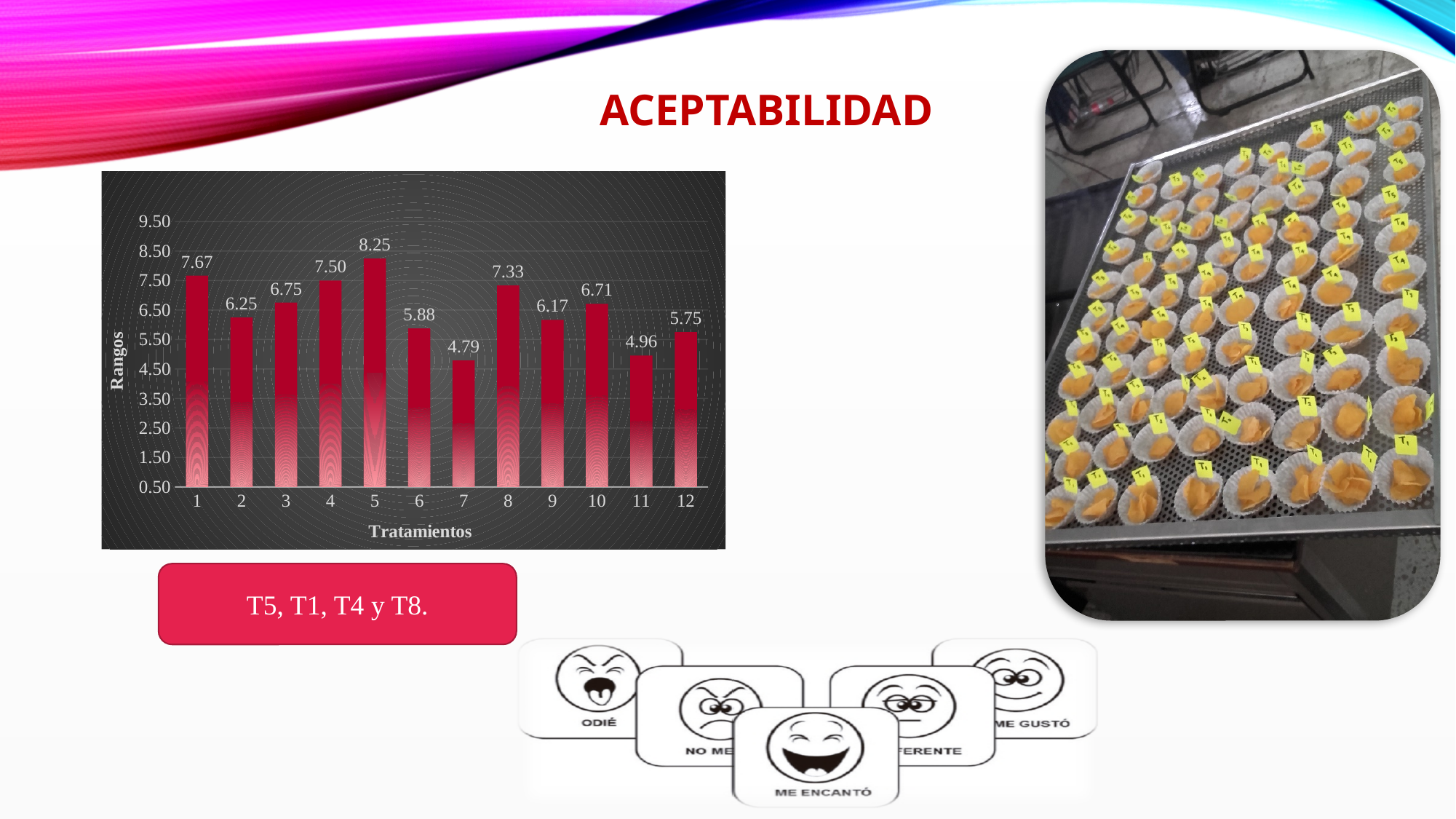
Which treatment has the lowest value? 7 What is the value for treatment 5? 8.25 Which treatment has the highest value? 5 Which has a larger value, treatment 4 or treatment 8? Treatment 4 What is the value for treatment 7? 4.79 Is the value for treatment 11 greater or less than 5.50? less What is the difference between the values for treatment 1 and treatment 2? 1.42 What is the value for treatment 10? 6.71 What kind of chart is shown on the slide? Bar chart How many treatments are shown on the x axis? 12 What is the label of the y axis? Rangos What is the difference between the values for treatment 5 and treatment 7? 3.46